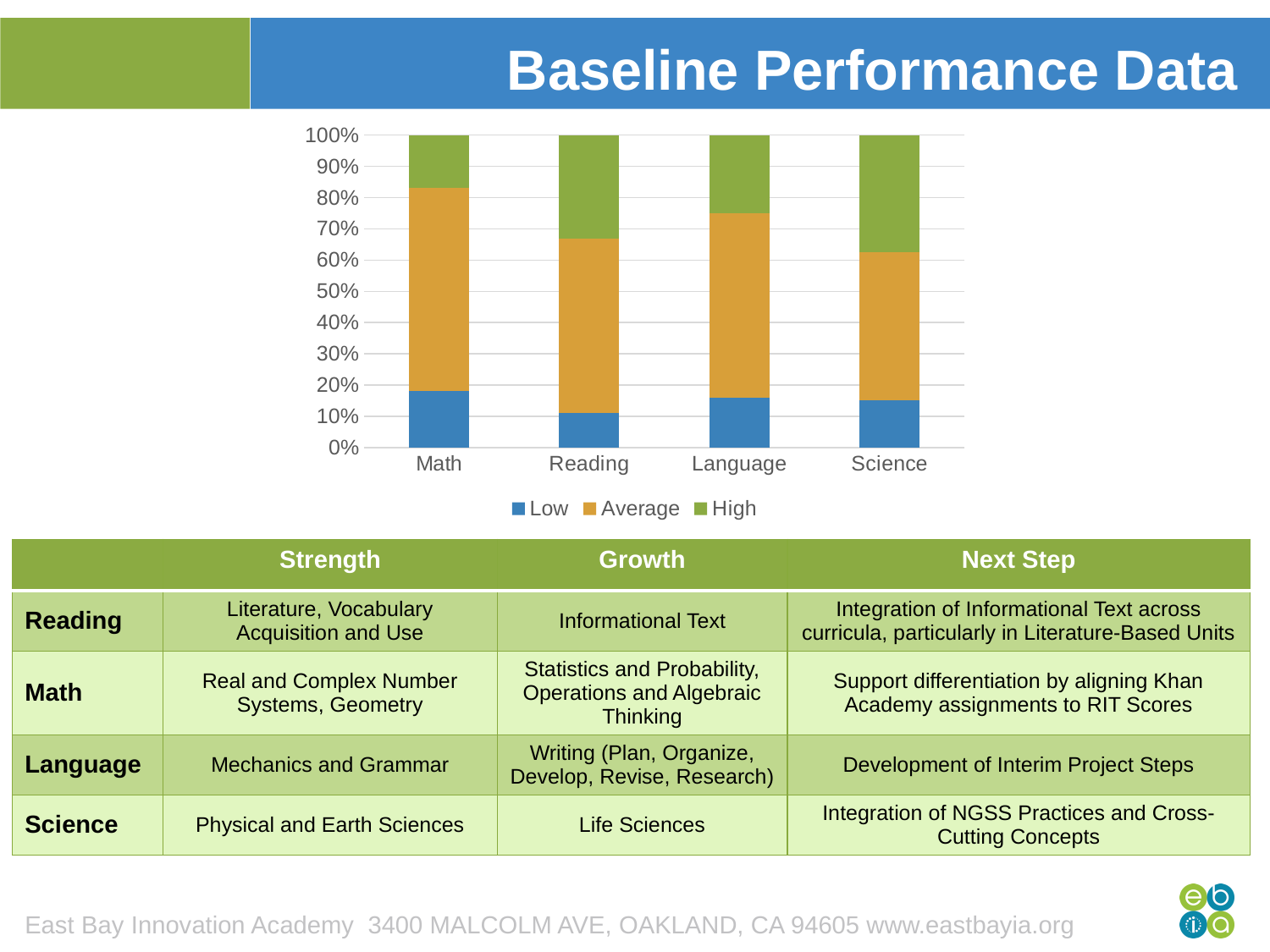
What is the title of the slide containing the chart? Baseline Performance Data Is the Low value for Math greater or less than 20%? less What is the total of the stacked bar for Language? 100% How many series does the chart legend list? 3 Which is larger, the High segment for Science or the High segment for Math? Science Is the top of the Average segment for Math greater or less than 80%? greater Is the Low value for Reading greater or less than 20%? less What are the three series named in the chart legend? Low, Average, High Which subject has the smallest High segment? Math What kind of chart is shown on the slide? Stacked bar chart How many subject categories are shown on the x axis of the chart? 4